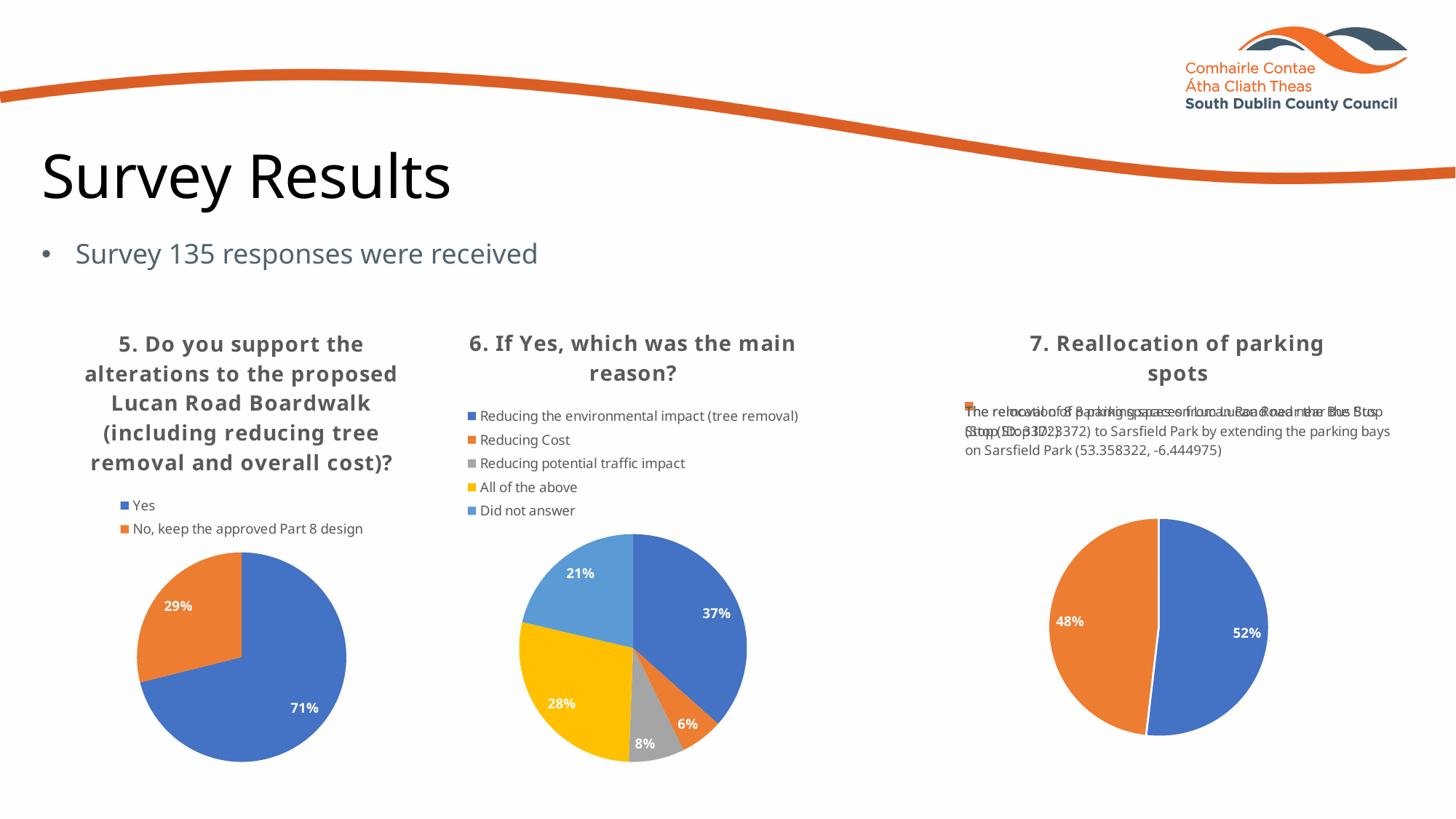
How many categories does the legend list for the chart for question 6 (If Yes, which was the main reason?)? 5 In the chart for question 7 (Reallocation of parking spots), what share does the orange slice represent? 48% What kind of chart is used for question 5 (Do you support the alterations to the proposed Lucan Road Boardwalk)? Pie chart In the chart for question 6 (If Yes, which was the main reason?), which reason has the smallest share? Reducing Cost In the chart for question 5 (Do you support the alterations), what share of responses is 'Yes'? 71% In the chart for question 6 (If Yes, which was the main reason?), which is larger: 'Reducing potential traffic impact' or 'Did not answer'? Did not answer In the chart for question 5 (Do you support the alterations), what share of responses is 'No, keep the approved Part 8 design'? 29% In the chart for question 7 (Reallocation of parking spots), what share does the blue slice represent? 52% In the chart for question 6 (If Yes, which was the main reason?), what share is 'Reducing the environmental impact (tree removal)'? 37% In the chart for question 6 (If Yes, which was the main reason?), which category has the largest share? Reducing the environmental impact (tree removal) In the chart for question 5 (Do you support the alterations), what is the difference between the 'Yes' and 'No' shares? 42% In the chart for question 6 (If Yes, which was the main reason?), what share is 'All of the above'? 28%